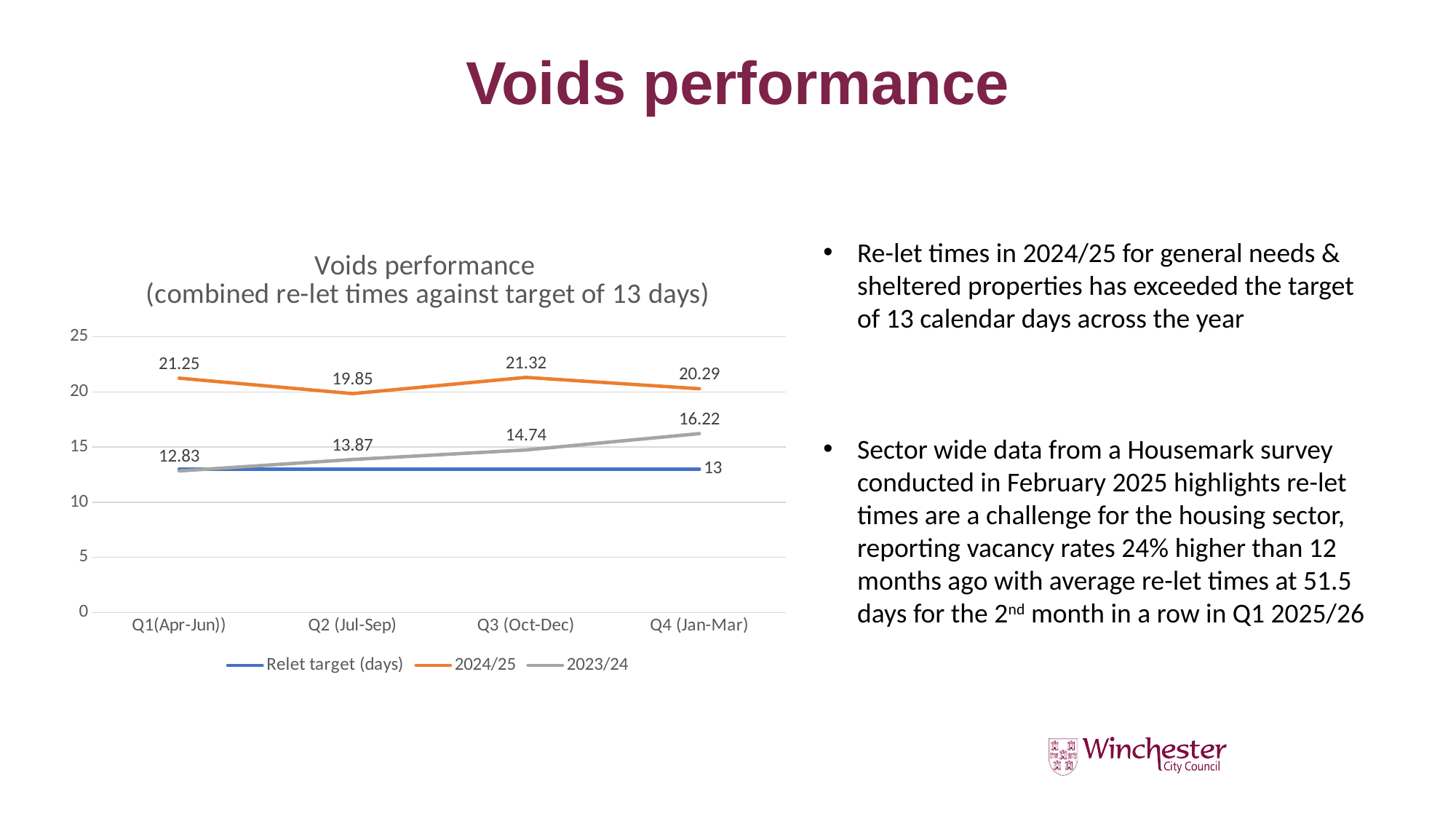
How many series does the legend list? 3 Does the 2023/24 re-let time rise or fall from Q1 to Q4? Rise How many quarters are shown on the x axis? 4 Which is larger in Q1: the 2024/25 re-let time or the 2023/24 re-let time? 2024/25 In which quarter is the 2024/25 re-let time lowest? Q2 (Jul-Sep) In which quarter is the 2023/24 re-let time lowest? Q1(Apr-Jun)) What is the difference between the 2024/25 and 2023/24 re-let times in Q4 (Jan-Mar)? 4.07 What is the 2024/25 re-let time for Q4 (Jan-Mar)? 20.29 What is the 2023/24 re-let time for Q2 (Jul-Sep)? 13.87 In which quarter is the 2024/25 re-let time highest? Q3 (Oct-Dec) What is the 2024/25 re-let time for Q3 (Oct-Dec)? 21.32 What kind of chart is shown on the slide? Line chart